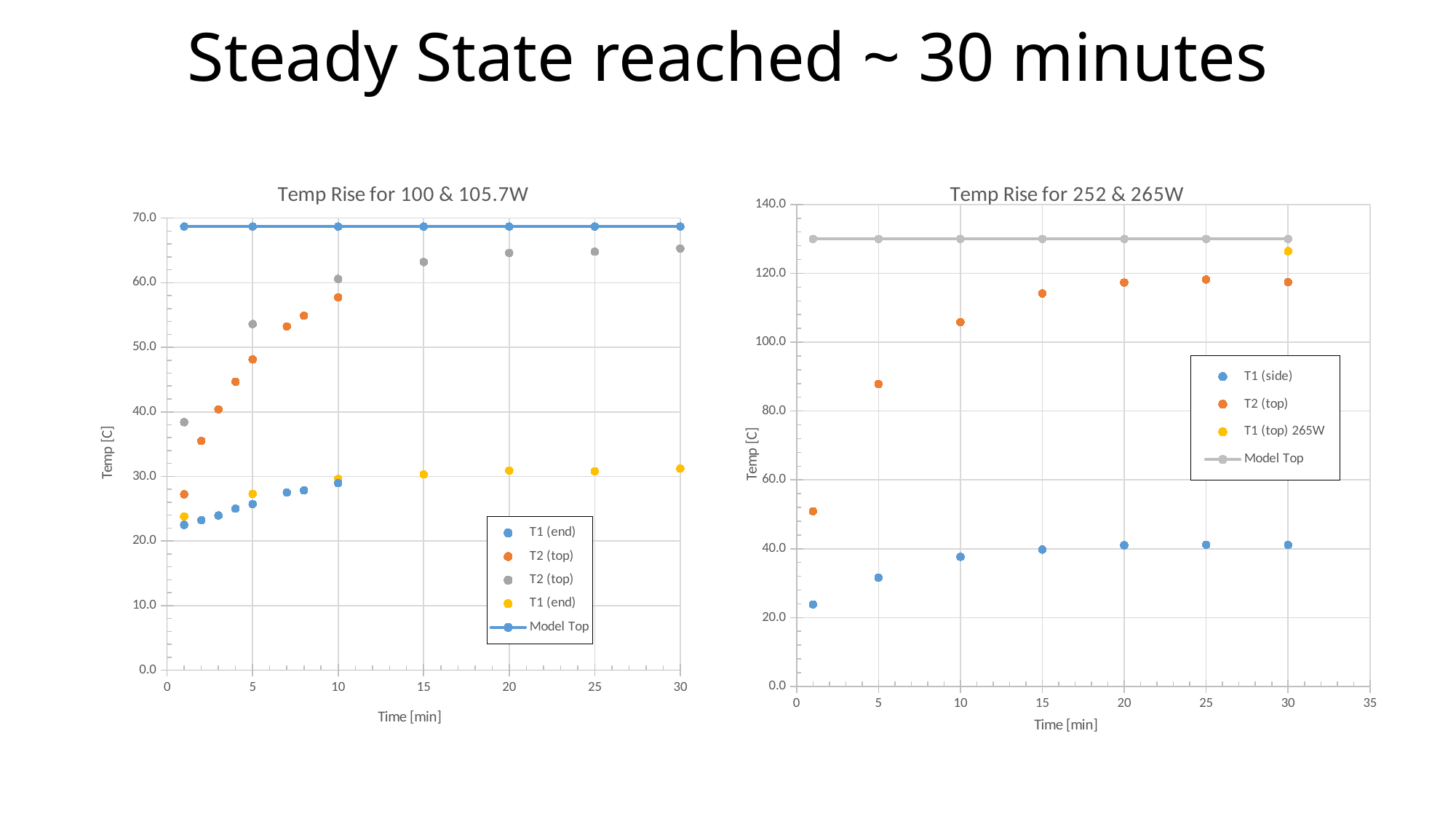
In the left chart, 'Temp Rise for 100 & 105.7W', is the Model Top value greater or less than 60? greater What type of chart is the left chart, 'Temp Rise for 100 & 105.7W'? scatter chart What is the y-axis title of the left chart, 'Temp Rise for 100 & 105.7W'? Temp [C] In the right chart, 'Temp Rise for 252 & 265W', is the T1 (side) value at 30 minutes greater or less than 60? less In the right chart, 'Temp Rise for 252 & 265W', does the T2 (top) series rise or fall as time increases? rise In the right chart, 'Temp Rise for 252 & 265W', is the Model Top value greater or less than 120? greater What is the x-axis title of the right chart, 'Temp Rise for 252 & 265W'? Time [min] How many series does the legend of the left chart, 'Temp Rise for 100 & 105.7W', list? 5 In the right chart, 'Temp Rise for 252 & 265W', how many points are plotted for the T1 (side) series? 7 In the right chart, 'Temp Rise for 252 & 265W', which is larger at 30 minutes: T2 (top) or T1 (side)? T2 (top) How many series does the legend of the right chart, 'Temp Rise for 252 & 265W', list? 4